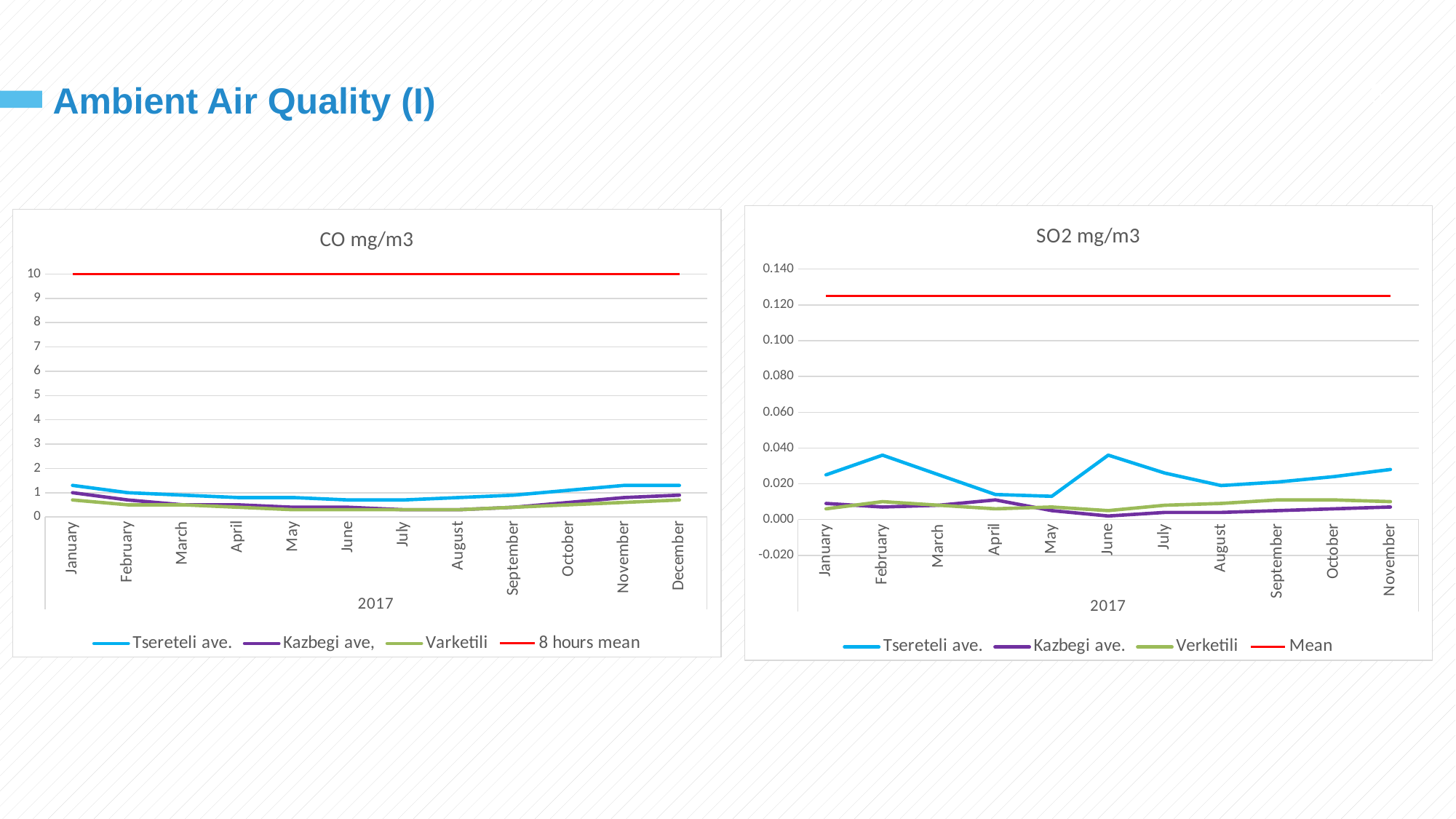
On the SO2 mg/m3 chart, which is larger in June, Tsereteli ave. or Kazbegi ave.? Tsereteli ave. On the SO2 mg/m3 chart, how many months are shown on the x axis? 11 On the SO2 mg/m3 chart, is the value for Tsereteli ave. in February greater or less than 0.020? greater On the CO mg/m3 chart, which is larger in January, Tsereteli ave. or Varketili? Tsereteli ave. On the CO mg/m3 chart, what kind of chart is it? line chart On the CO mg/m3 chart, how many months are shown on the x axis? 12 On the CO mg/m3 chart, does the Tsereteli ave. line rise or fall from January to July? fall On the SO2 mg/m3 chart, what is the name of the red series in the legend? Mean On the CO mg/m3 chart, what value does the 8 hours mean line sit at? 10 On the SO2 mg/m3 chart, how many series does the legend list? 4 On the CO mg/m3 chart, how many series does the legend list? 4 On the CO mg/m3 chart, is the value for Tsereteli ave. in January greater or less than 2? less